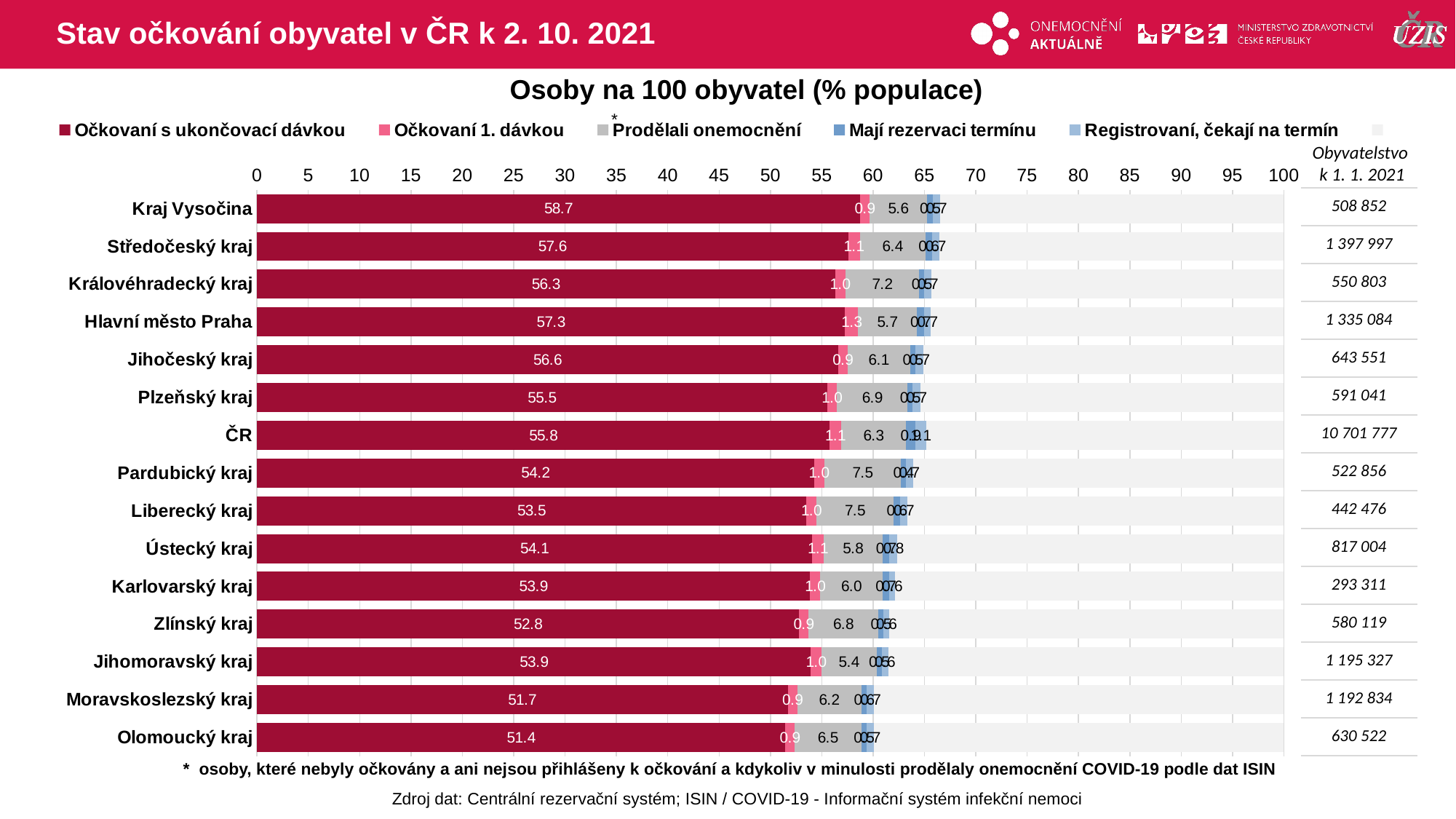
What is the value of Prodělali onemocnění for Pardubický kraj? 7.5 Which category has the lowest value of Očkovaní s ukončovací dávkou? Olomoucký kraj What is the difference in Očkovaní s ukončovací dávkou between Kraj Vysočina and Olomoucký kraj? 7.3 How many categories (rows) are shown in the chart? 15 Is the value of Očkovaní s ukončovací dávkou for ČR greater or less than 50? greater Which has a higher value of Očkovaní s ukončovací dávkou, Jihočeský kraj or Plzeňský kraj? Jihočeský kraj What is the value of Očkovaní 1. dávkou for Hlavní město Praha? 1.3 What is the title of the chart? Osoby na 100 obyvatel (% populace) What is the value of Očkovaní s ukončovací dávkou for Kraj Vysočina? 58.7 Which category has the highest value of Očkovaní s ukončovací dávkou? Kraj Vysočina What kind of chart is shown on the slide? Stacked bar chart What is the value of Očkovaní s ukončovací dávkou for Olomoucký kraj? 51.4